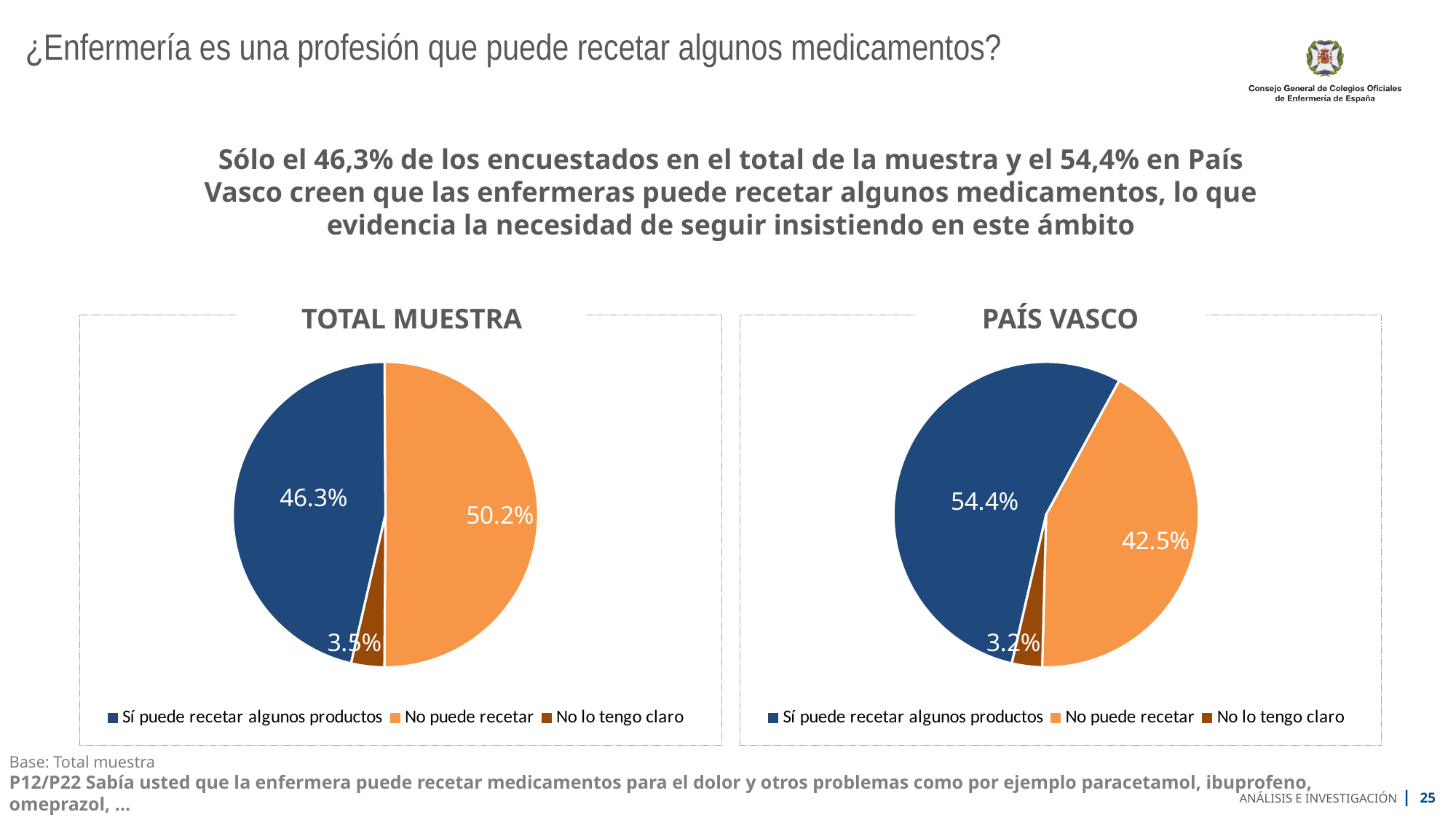
Which is larger: 'Sí puede recetar algunos productos' in the TOTAL MUESTRA chart or in the PAÍS VASCO chart? PAÍS VASCO In the TOTAL MUESTRA chart, what is the value for 'Sí puede recetar algunos productos'? 46.3% In the PAÍS VASCO chart, which category has the smallest slice? No lo tengo claro What type of chart is the TOTAL MUESTRA chart? Pie chart In the TOTAL MUESTRA chart, which category has the largest slice? No puede recetar In the TOTAL MUESTRA chart, what is the value for 'No puede recetar'? 50.2% In the PAÍS VASCO chart, what is the value for 'No lo tengo claro'? 3.2% In the TOTAL MUESTRA chart, what is the difference between 'No puede recetar' and 'No lo tengo claro'? 46.7% In the PAÍS VASCO chart, what is the value for 'Sí puede recetar algunos productos'? 54.4% How many slices does the PAÍS VASCO pie chart have? 3 In the TOTAL MUESTRA chart, what colour is the 'No puede recetar' slice? Orange In the PAÍS VASCO chart, what is the difference between 'Sí puede recetar algunos productos' and 'No puede recetar'? 11.9%